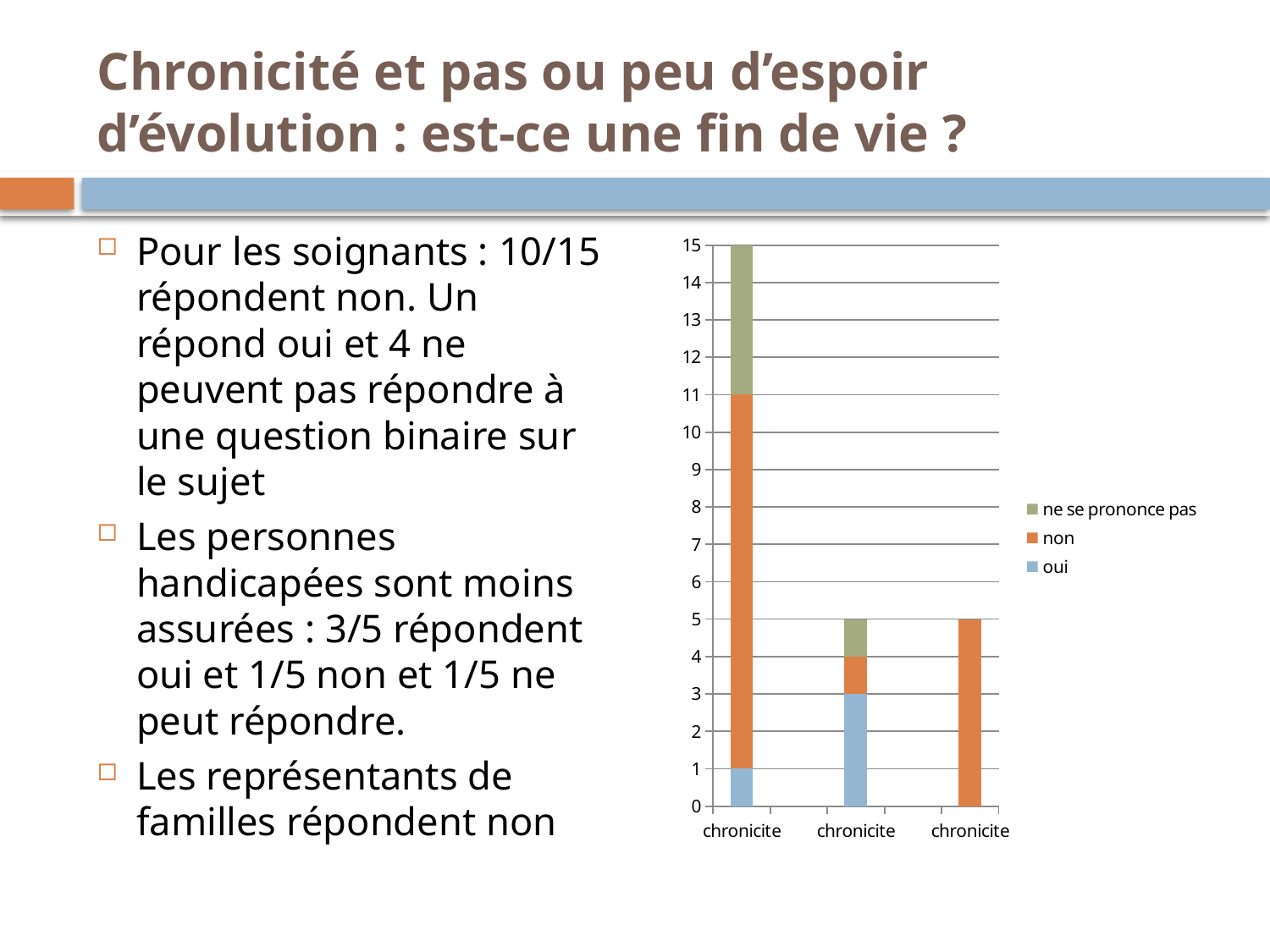
What are the three entries listed in the chart legend? ne se prononce pas, non, oui How many bars are plotted in the chart? 3 What is the total height of the leftmost stacked bar? 15 What is the total height of the middle stacked bar? 5 How many series does the chart legend list? 3 Which is larger, the total of the leftmost bar or the total of the middle bar? the leftmost bar Is the total of the leftmost bar greater or less than 10? greater What is the value of the 'oui' series in the middle bar? 3 What is the value of the 'oui' series in the leftmost bar? 1 What kind of chart is shown on the slide? bar chart What is the total height of the rightmost bar? 5 Which bar has the highest total value? the leftmost bar